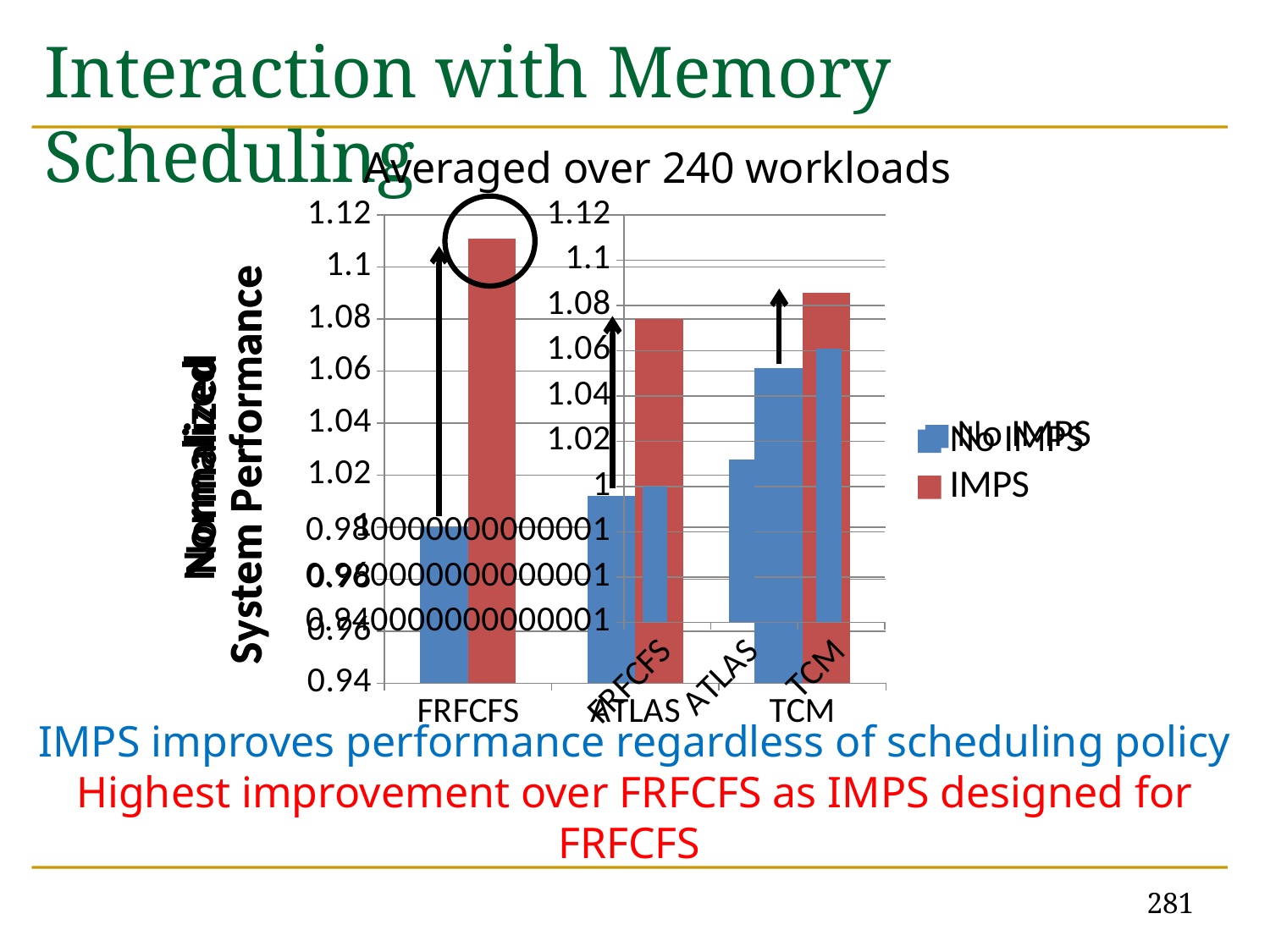
What are the two series named in the chart legend? No IMPS and IMPS Which category has the highest IMPS bar? FRFCFS Is the No IMPS value for TCM greater or less than 1.08? less How many series does the chart legend list? 2 Is the IMPS value for FRFCFS greater or less than 1.1? greater Is the No IMPS value for TCM greater or less than 1.04? greater Do the No IMPS bars rise or fall going from FRFCFS to ATLAS to TCM? rise Which category has the lowest No IMPS bar? FRFCFS For FRFCFS, which is larger: the IMPS bar or the No IMPS bar? IMPS What kind of chart is shown on the slide? bar chart How many scheduling policies (categories) are shown on the x axis of the chart? 3 What is the title shown above the chart? Averaged over 240 workloads